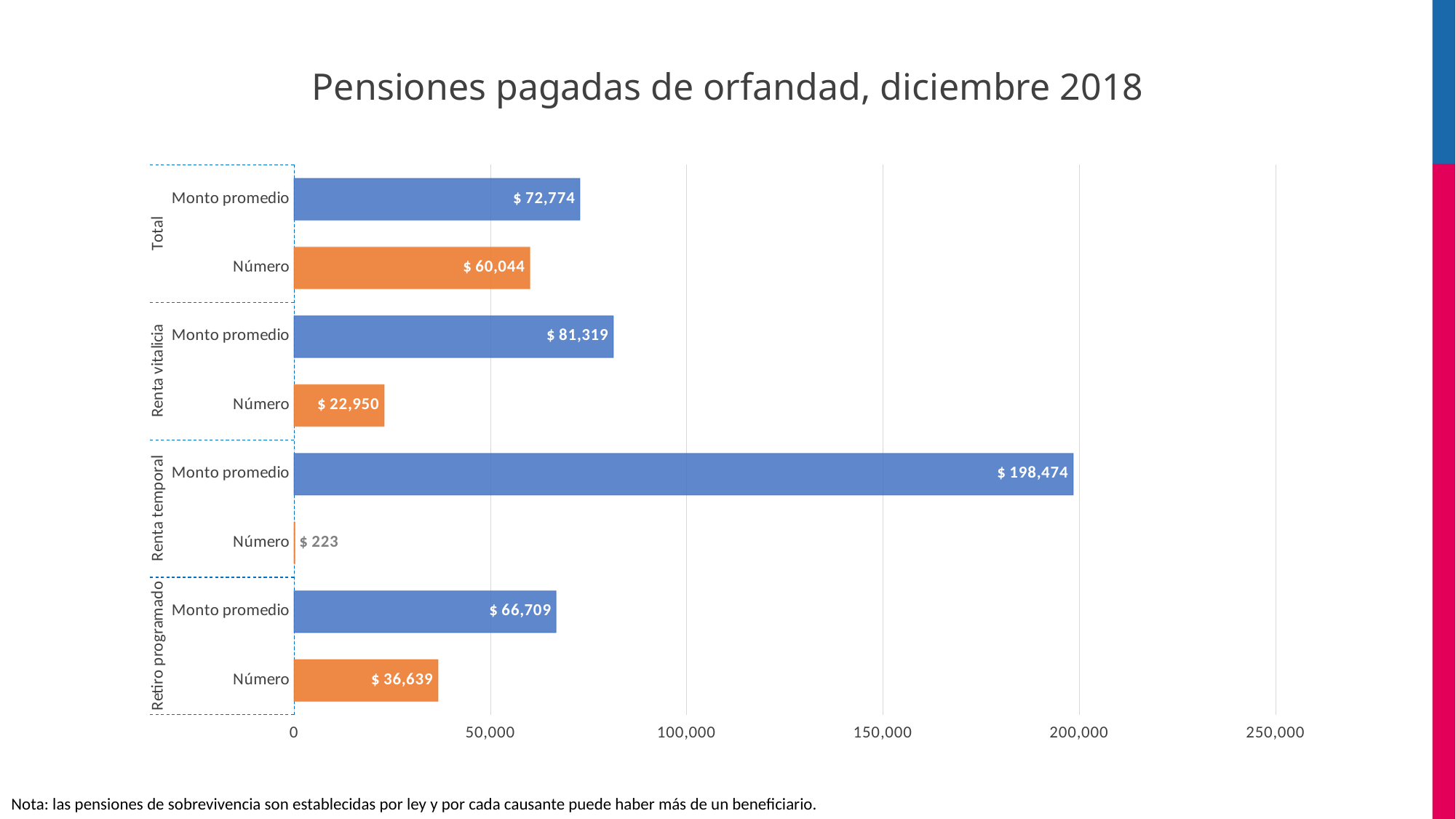
Which bar has the highest value on the chart? Monto promedio, Renta temporal Is the Monto promedio value for Renta temporal greater or less than 150,000? greater Which bar has the lowest value on the chart? Número, Renta temporal Which is larger: the Número for Total or the Número for Retiro programado? Número for Total What is the Número value for Renta vitalicia? $ 22,950 What is the Monto promedio value for Renta temporal? $ 198,474 How many bars are plotted on the chart? 8 What kind of chart is shown on the slide? Bar chart What is the title of the chart? Pensiones pagadas de orfandad, diciembre 2018 What is the Monto promedio value for Total? $ 72,774 What is the difference between the Monto promedio for Renta vitalicia and the Monto promedio for Retiro programado? $ 14,610 What is the Número value for Retiro programado? $ 36,639